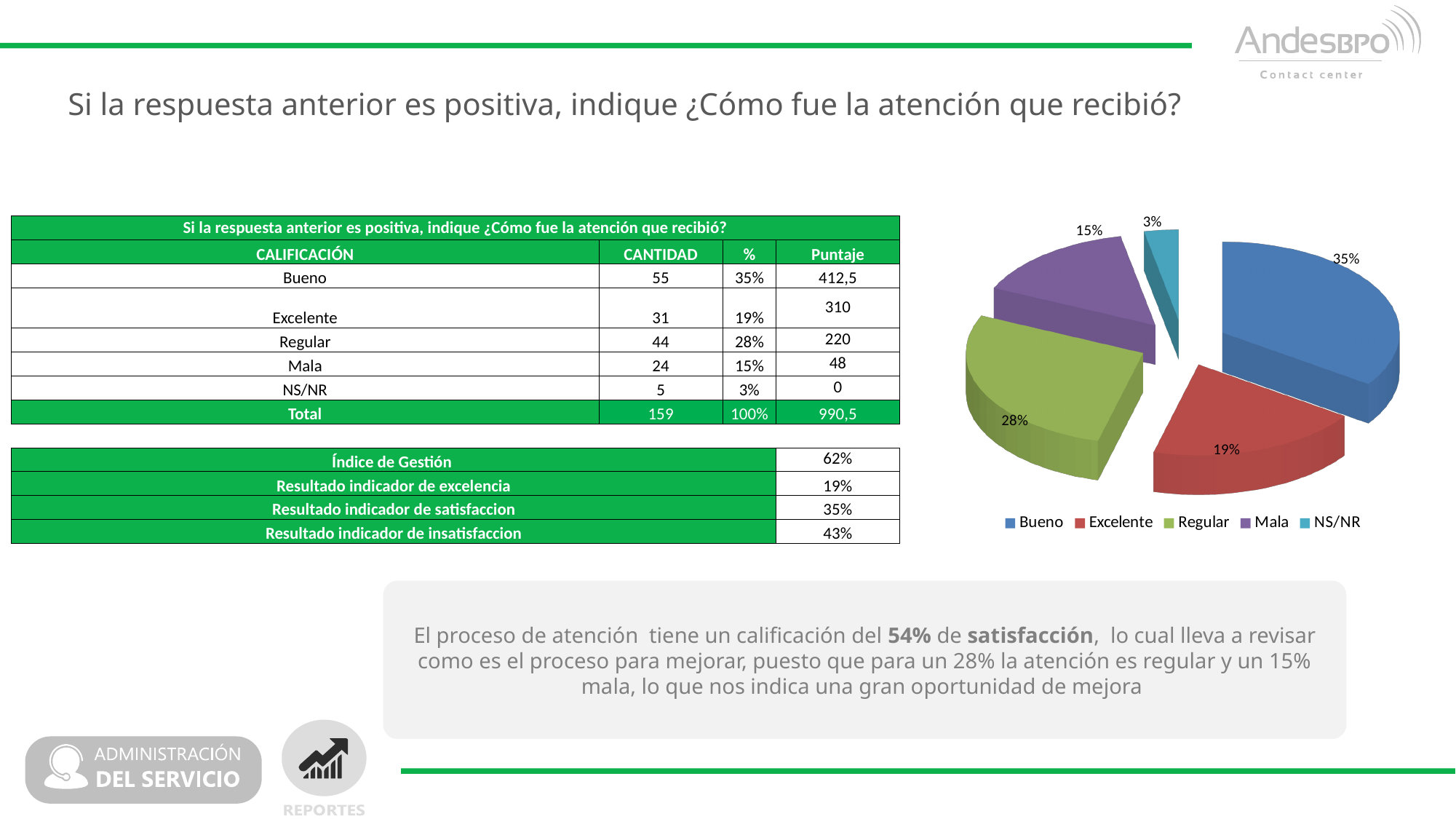
How many categories does the pie chart legend list? 5 What colour is the Regular slice in the pie chart? green What percentage does the Mala slice show in the pie chart? 15% Which category has the largest slice in the pie chart? Bueno Which slice is larger in the pie chart, Excelente or Mala? Excelente What percentage does the Regular slice show in the pie chart? 28% What percentage does the NS/NR slice show in the pie chart? 3% Which category has the smallest slice in the pie chart? NS/NR What percentage does the Excelente slice show in the pie chart? 19% What is the difference in percentage points between the Bueno and Regular slices? 7 What percentage does the Bueno slice show in the pie chart? 35% What kind of chart is shown on the slide? pie chart